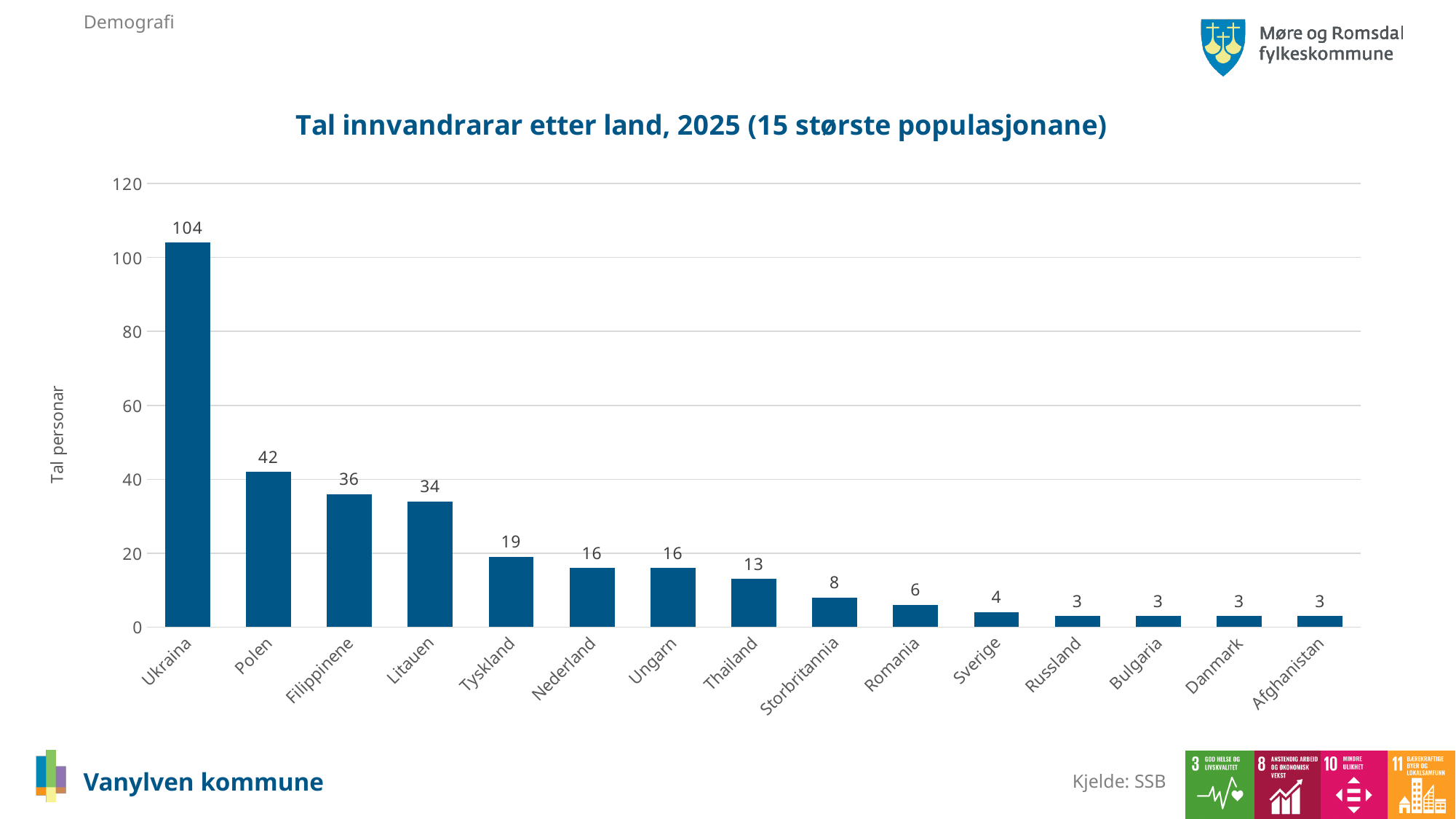
Do the values rise or fall from left to right along the x axis? fall What is the value for Ukraina? 104 Which country has the highest value? Ukraina Which is larger, the value for Tyskland or the value for Thailand? Tyskland What is the value for Filippinene? 36 How many countries are shown on the x axis? 15 What kind of chart is this? bar chart What is the label of the y axis? Tal personar What is the title of the chart? Tal innvandrarar etter land, 2025 (15 største populasjonane) What is the difference between the values for Polen and Litauen? 8 What is the value for Storbritannia? 8 Is the value for Ukraina greater or less than 100? greater